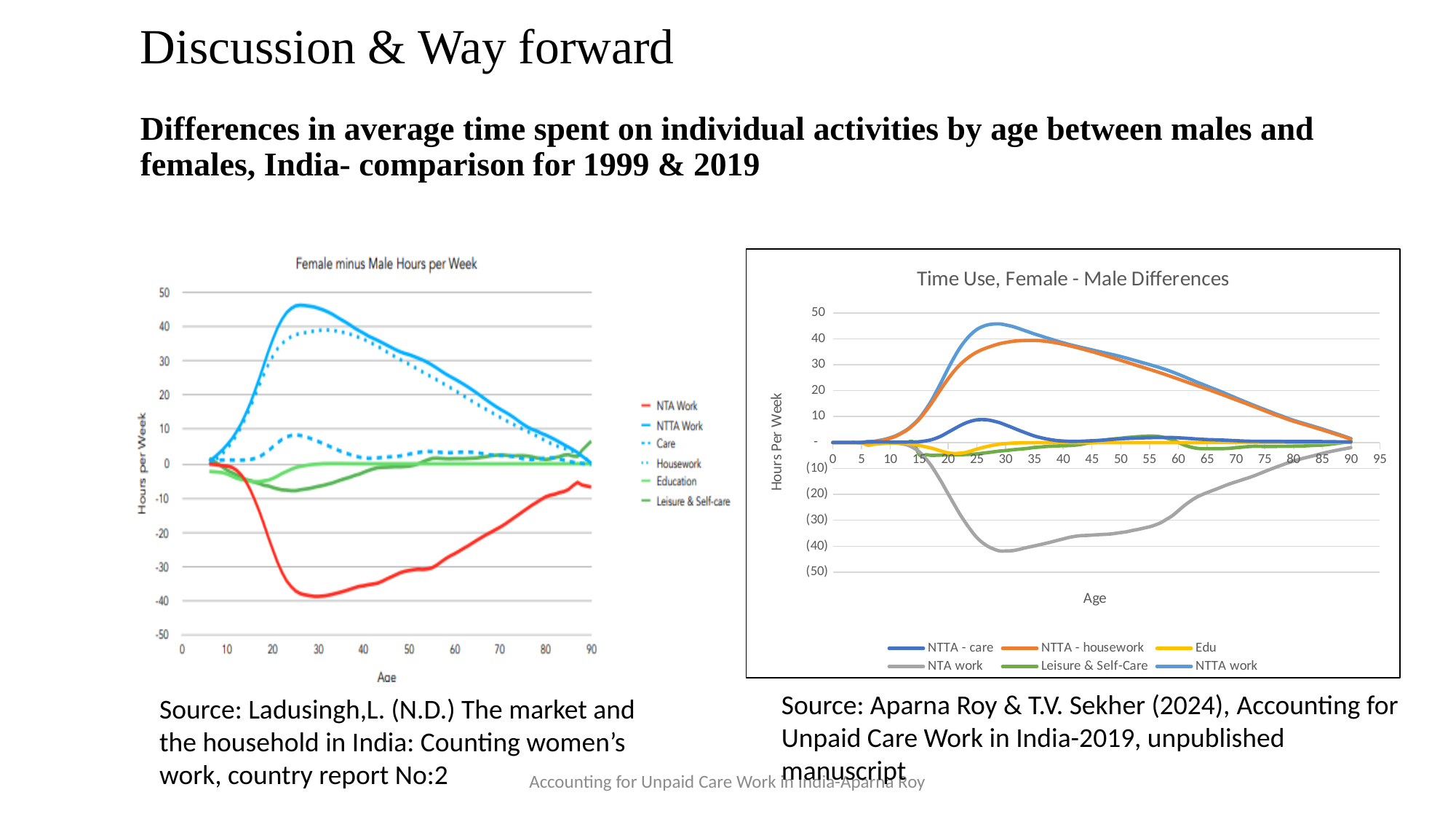
What is the x-axis label of the right chart "Time Use, Female - Male Differences"? Age What type of chart is the left chart titled "Female minus Male Hours per Week"? line chart In the right chart "Time Use, Female - Male Differences", which series reaches the highest value? NTTA work How many series does the legend of the left chart "Female minus Male Hours per Week" list? 6 How many series does the legend of the right chart "Time Use, Female - Male Differences" list? 6 In the right chart "Time Use, Female - Male Differences", does the NTTA work line rise or fall between age 40 and age 90? fall In the left chart "Female minus Male Hours per Week", is the peak value of the NTTA Work line greater or less than 40? greater In the right chart "Time Use, Female - Male Differences", is the lowest value of the NTA work line greater or less than (30)? less In the left chart "Female minus Male Hours per Week", is the lowest value of the NTA Work line greater or less than -30? less In the left chart "Female minus Male Hours per Week", which series reaches the lowest value? NTA Work What type of chart is the right chart titled "Time Use, Female - Male Differences"? line chart